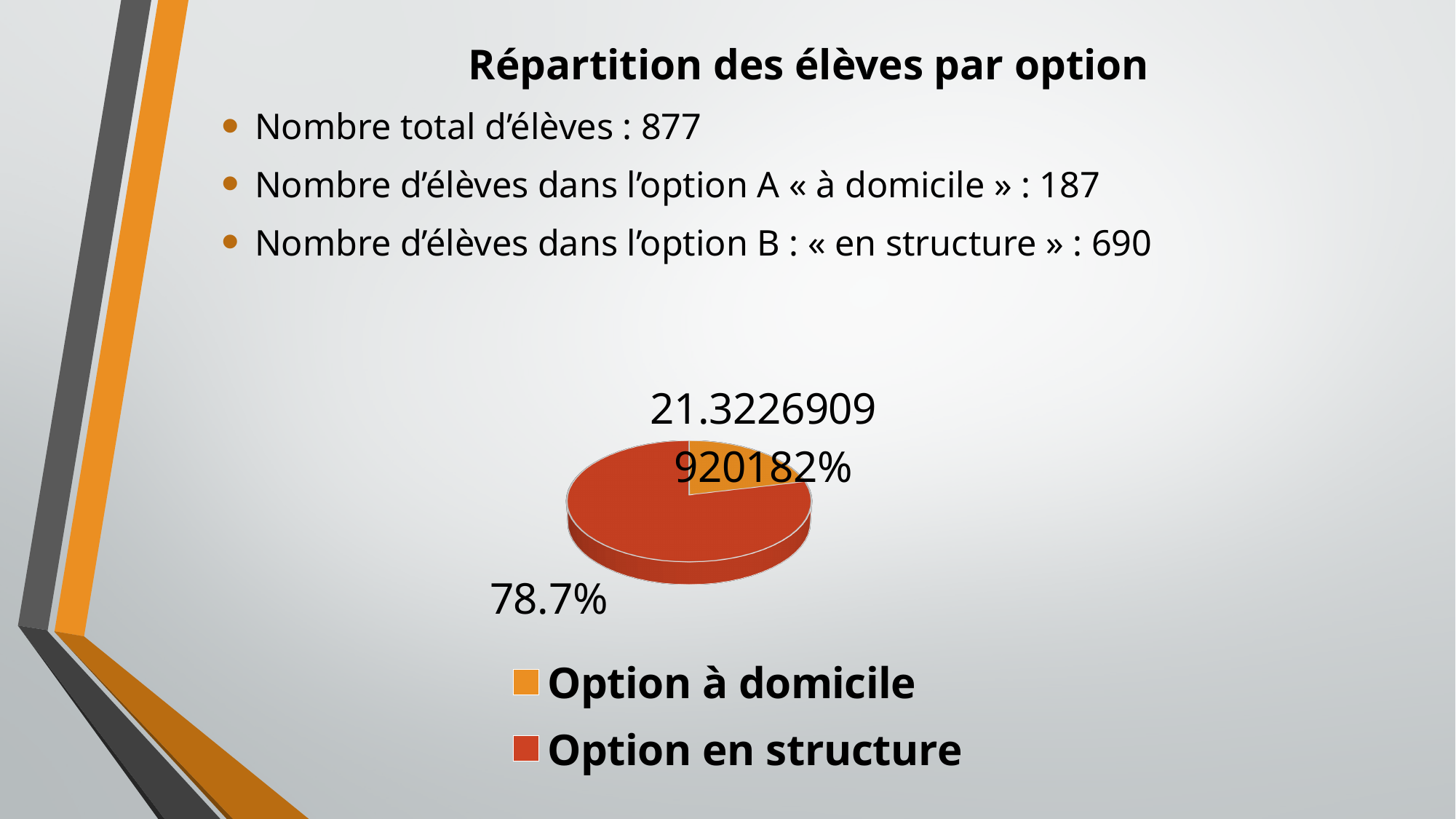
Which is larger in the pie chart, 'Option à domicile' or 'Option en structure'? Option en structure What colour is the 'Option à domicile' slice in the pie chart? orange What kind of chart is shown on the slide? pie chart Which slice of the pie chart is the largest? Option en structure What percentage is shown for the 'Option à domicile' slice? 21.3226909920182% What colour is the 'Option en structure' slice in the pie chart? red What percentage is shown for the 'Option en structure' slice? 78.7% How many slices does the pie chart have? 2 What share of the pie does 'Option en structure' represent? 78.7% How many entries does the legend of the pie chart list? 2 Which slice of the pie chart is the smallest? Option à domicile